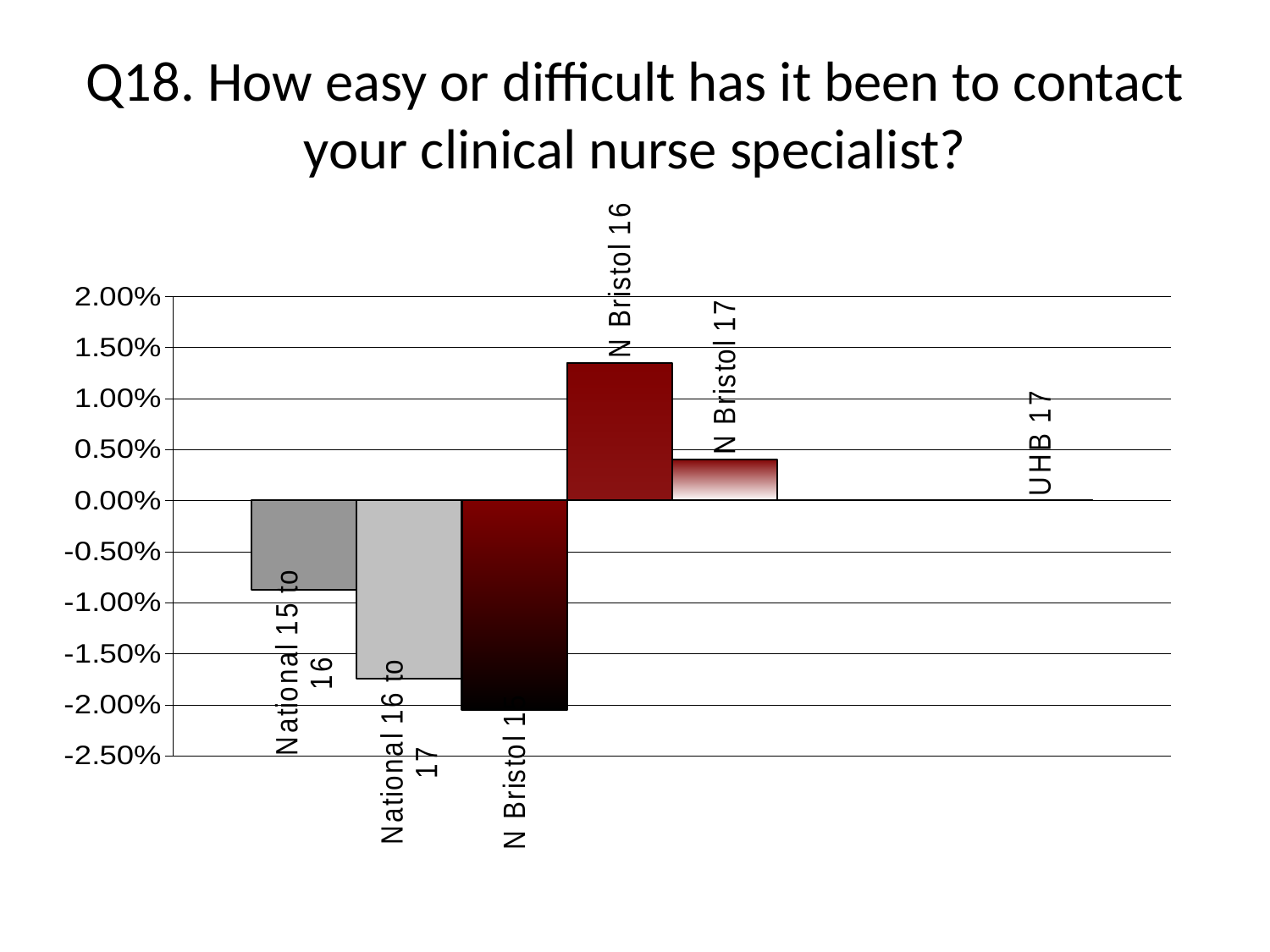
Is the value for N Bristol 16 greater or less than 1.00%? greater Which category has the highest value in the chart? N Bristol 16 Is the value for N Bristol 16 greater or less than 1.50%? less Is the value for National 16 to 17 greater or less than -1.50%? less Which is larger, the value for N Bristol 16 or the value for N Bristol 17? N Bristol 16 Which is larger, the value for National 15 to 16 or the value for National 16 to 17? National 15 to 16 What is the title of the slide? Q18. How easy or difficult has it been to contact your clinical nurse specialist? Which category shows no visible bar in the chart? UHB 17 What kind of chart is shown on the slide? bar chart